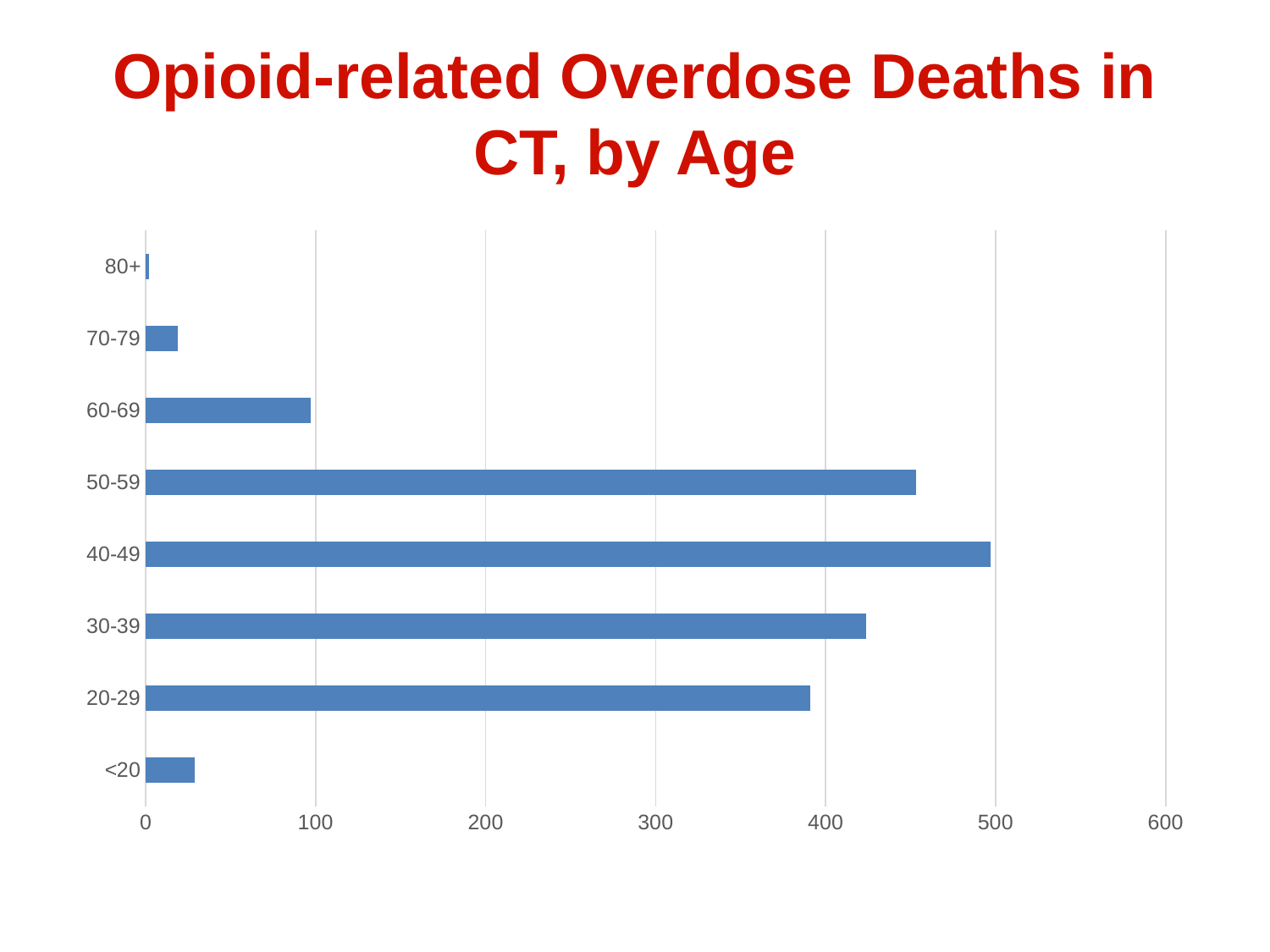
Which age group has more overdose deaths, 50-59 or 30-39? 50-59 Is the value for the 50-59 age group greater or less than 400? greater Is the value for the 20-29 age group greater or less than 300? greater Which age group has more overdose deaths, 20-29 or 30-39? 30-39 How many age categories are shown in the chart? 8 Which age group has more overdose deaths, 60-69 or <20? 60-69 What is the title of the chart? Opioid-related Overdose Deaths in CT, by Age What kind of chart is shown on the slide? bar chart Which age group has the highest number of opioid-related overdose deaths? 40-49 Is the value for the 70-79 age group greater or less than 100? less Which age group has the lowest number of opioid-related overdose deaths? 80+